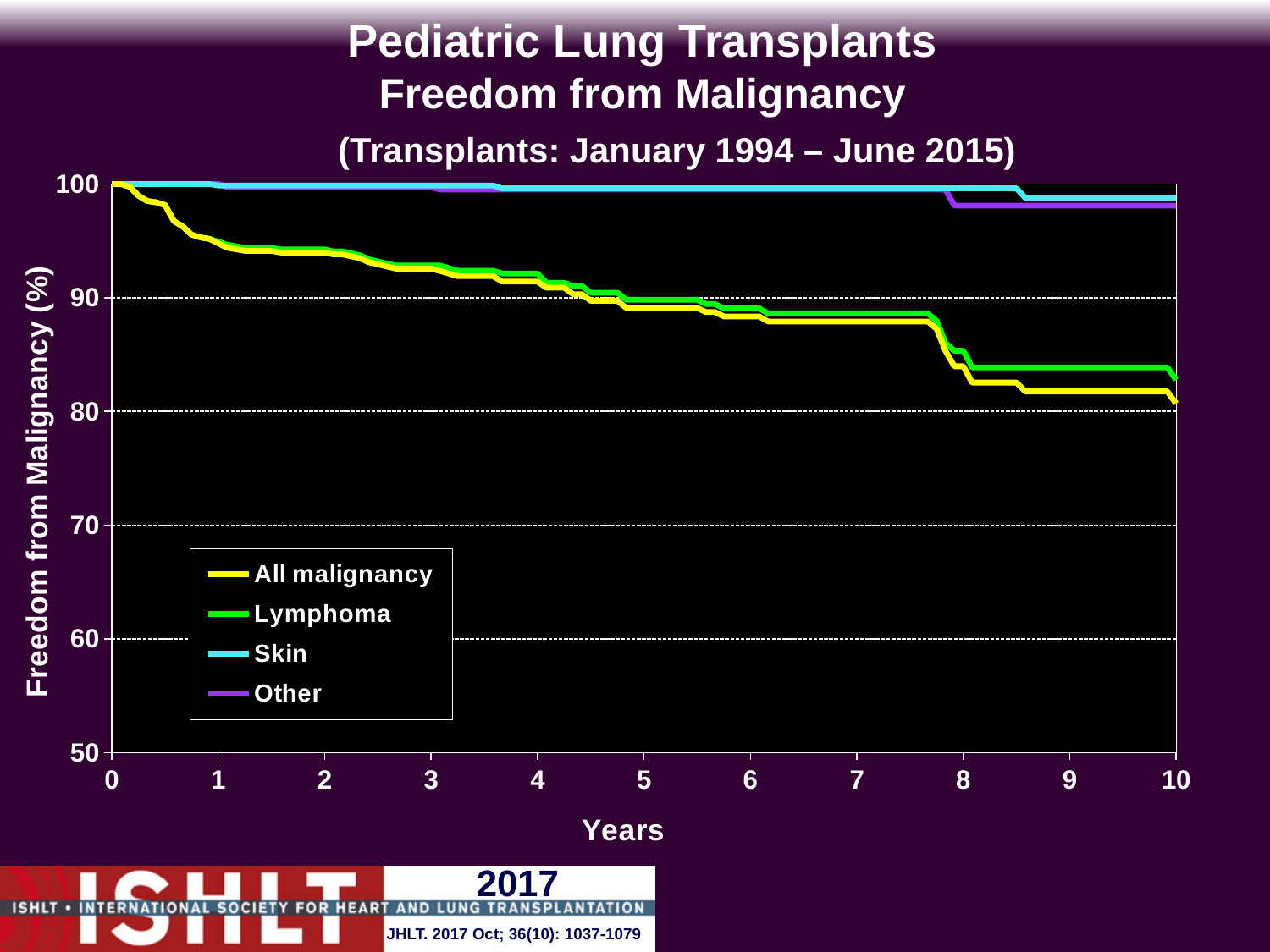
What is the label of the y axis? Freedom from Malignancy (%) Is the value for Skin at year 10 greater or less than 90? greater What kind of chart is shown on the slide? line chart How many series does the legend list? 4 Is the value for All malignancy at year 10 greater or less than 90? less What is the value of the All malignancy line at year 0? 100 Does the All malignancy line rise or fall as years increase? fall Is the value for Lymphoma at year 10 greater or less than 80? greater At year 10, which series has the lowest freedom from malignancy? All malignancy What colour is the Lymphoma line in the legend? green At year 10, which is higher, the Lymphoma line or the All malignancy line? Lymphoma